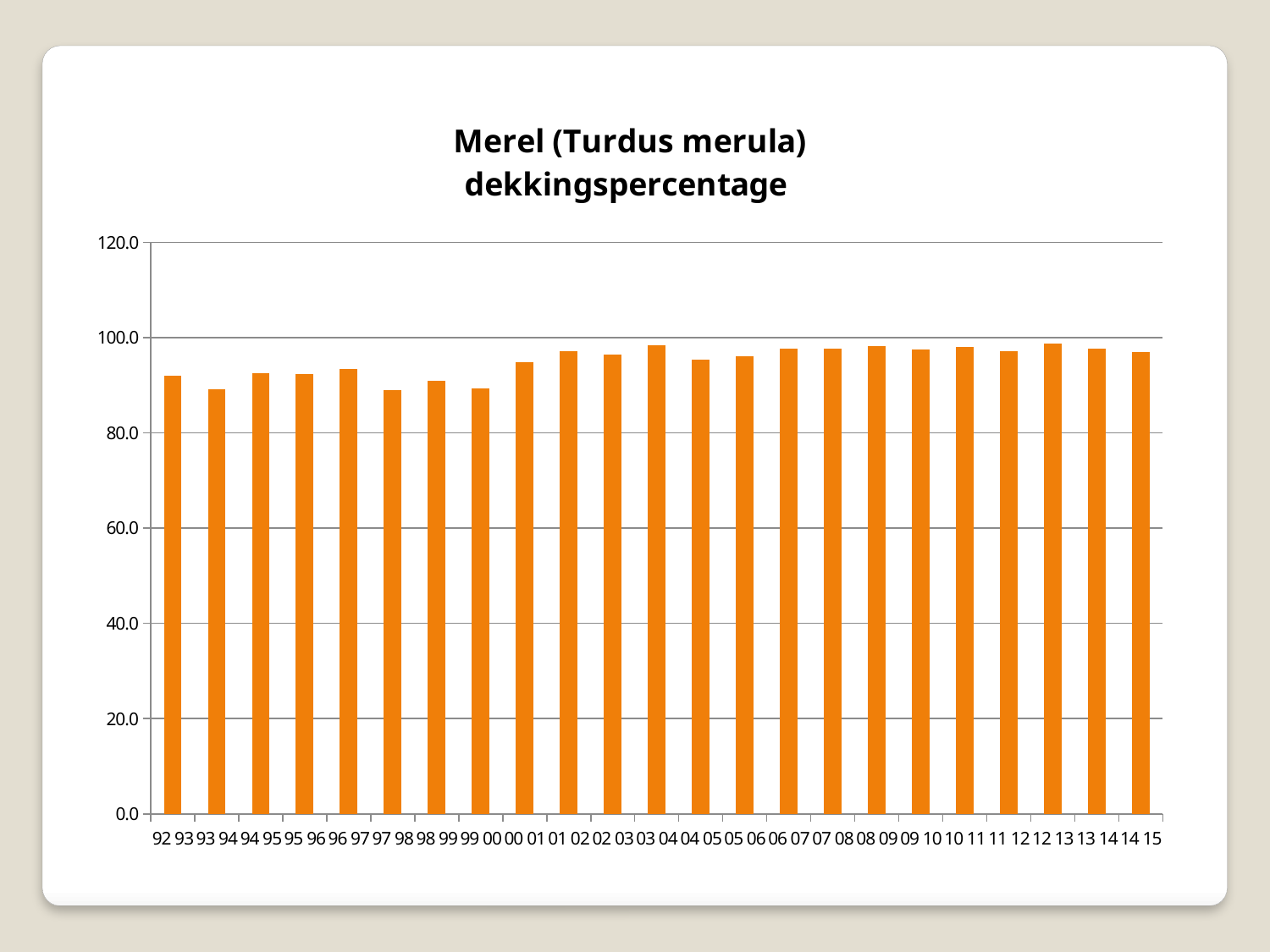
What is the title of the chart? Merel (Turdus merula) dekkingspercentage Is the value for 93 94 greater or less than 80? greater Is the value for 03 04 greater or less than 80? greater How many bars (seasons) are plotted in the chart? 23 Which is larger, the value for 92 93 or the value for 01 02? 01 02 Do the values rise or fall from 97 98 to 03 04? rise Which is larger, the value for 97 98 or the value for 03 04? 03 04 Is the value for 12 13 greater or less than 100? less What kind of chart is shown on the slide? bar chart What is the highest value shown on the vertical axis? 120.0 What is the first season label on the horizontal axis? 92 93